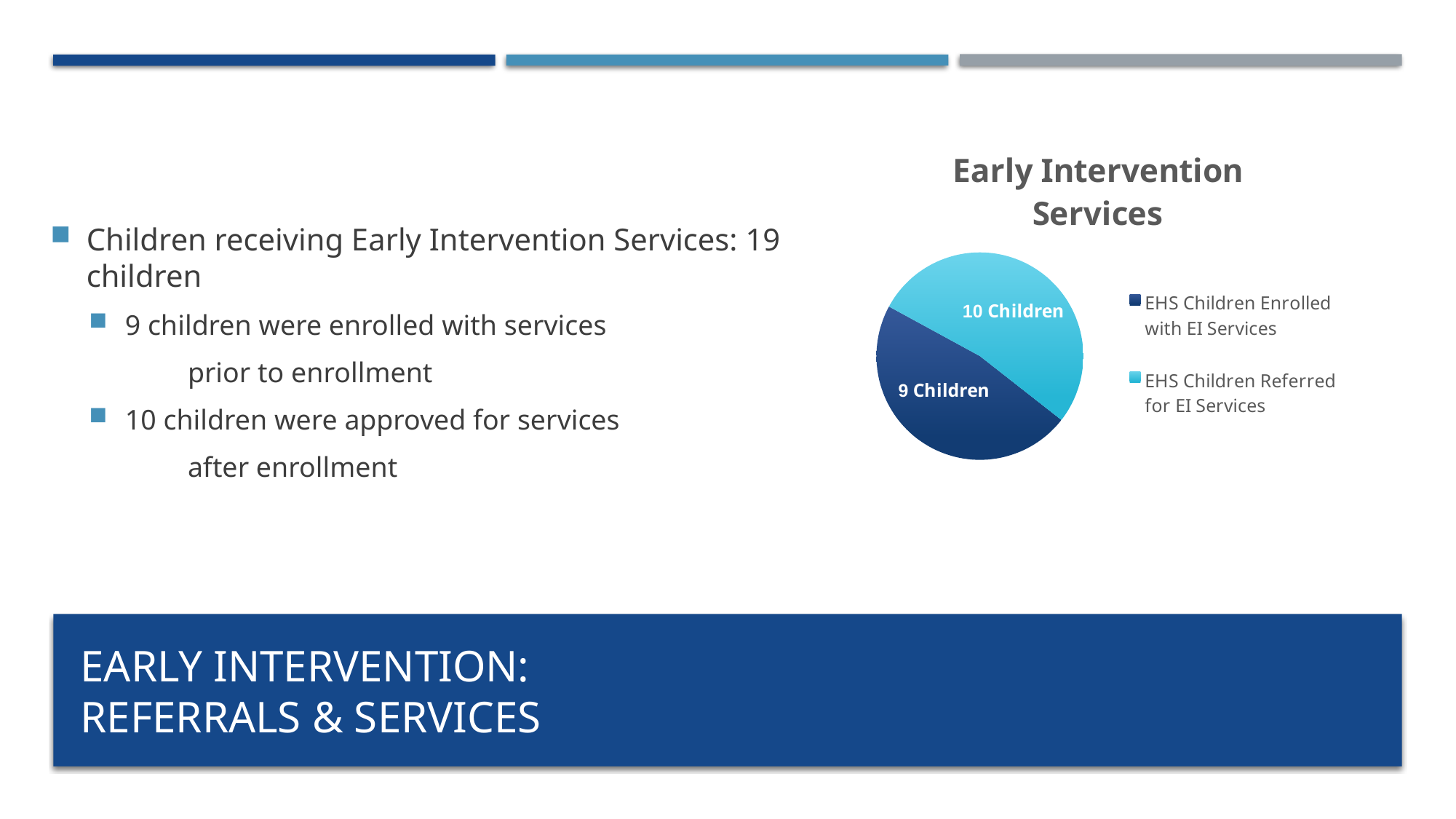
Which slice of the pie is the smallest? EHS Children Enrolled with EI Services What is the total number of children represented in the pie chart? 19 Which colour represents EHS Children Referred for EI Services in the pie chart? light blue What is the difference between the number of children referred for EI Services and the number enrolled with EI Services? 1 Which is larger: EHS Children Enrolled with EI Services or EHS Children Referred for EI Services? EHS Children Referred for EI Services What is the value shown for EHS Children Referred for EI Services? 10 Children What kind of chart is shown on the slide? pie chart What is the value shown for EHS Children Enrolled with EI Services? 9 Children How many entries does the chart legend list? 2 What is the title of the chart? Early Intervention Services How many slices does the pie chart have? 2 Which slice of the pie is the largest? EHS Children Referred for EI Services